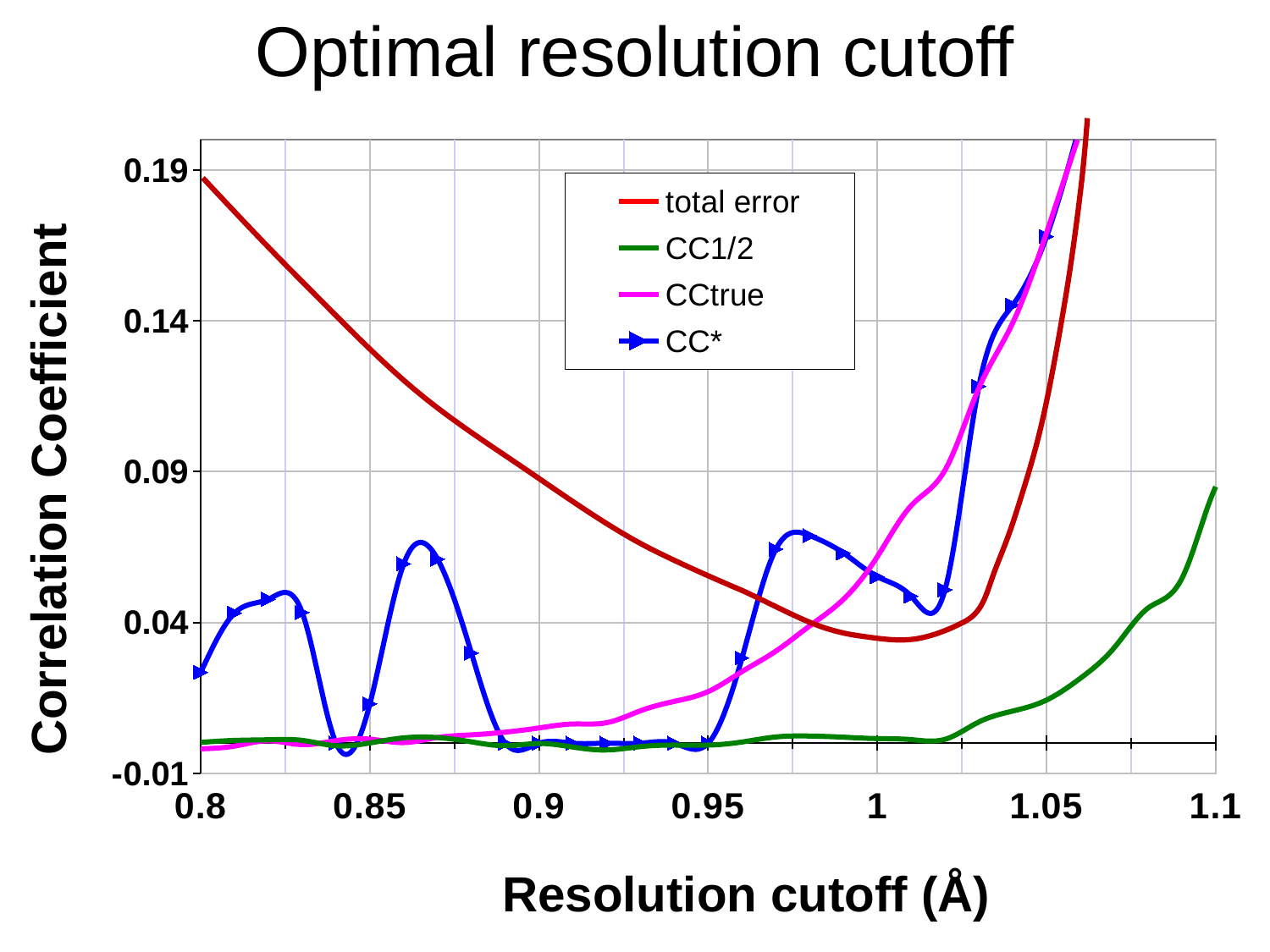
What kind of chart is shown on the slide? line chart At a resolution cutoff of 1.05, which series has the larger value, total error or CCtrue? CCtrue Is the value of the CC1/2 series at a resolution cutoff of 0.9 greater or less than 0.04? less What is the title of the chart? Optimal resolution cutoff Does the total error series rise or fall as the resolution cutoff increases from 0.8 to 1.0? fall Is the value of the CCtrue series at a resolution cutoff of 1.05 greater or less than 0.14? greater What is the label of the x axis? Resolution cutoff (Å) Is the value of the CC* series at a resolution cutoff of 0.85 greater or less than 0.04? less At a resolution cutoff of 0.9, which series has the larger value, total error or CC1/2? total error Which series has the highest value at a resolution cutoff of 0.8? total error How many series does the legend list? 4